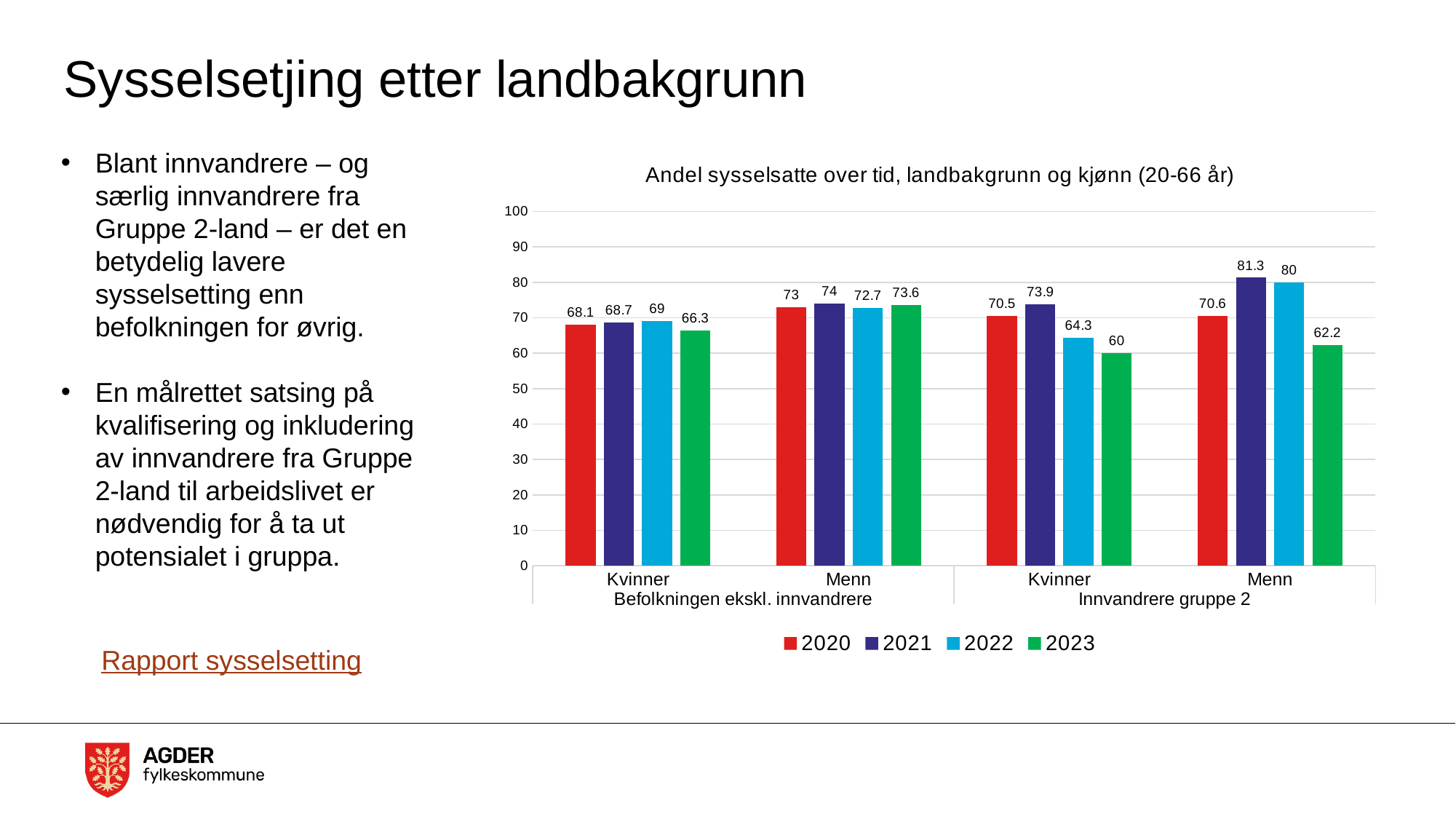
Which bar has the highest value in the chart? 2021, Menn, Innvandrere gruppe 2 Which bar has the lowest value in the chart? 2023, Kvinner, Innvandrere gruppe 2 What is the 2023 value for Kvinner in the Innvandrere gruppe 2 group? 60 What is the difference between the 2021 and 2023 values for Menn in the Innvandrere gruppe 2 group? 19.1 What is the title of the chart? Andel sysselsatte over tid, landbakgrunn og kjønn (20-66 år) What kind of chart is shown on the slide? Bar chart Which is larger: the 2022 value for Kvinner in Befolkningen ekskl. innvandrere or the 2022 value for Kvinner in Innvandrere gruppe 2? Kvinner in Befolkningen ekskl. innvandrere How many series does the legend list? 4 What is the 2021 value for Menn in the Innvandrere gruppe 2 group? 81.3 Do the values for Kvinner in the Innvandrere gruppe 2 group rise or fall from 2021 to 2023? Fall What is the 2022 value for Menn in the Befolkningen ekskl. innvandrere group? 72.7 What is the 2020 value for Kvinner in the Befolkningen ekskl. innvandrere group? 68.1